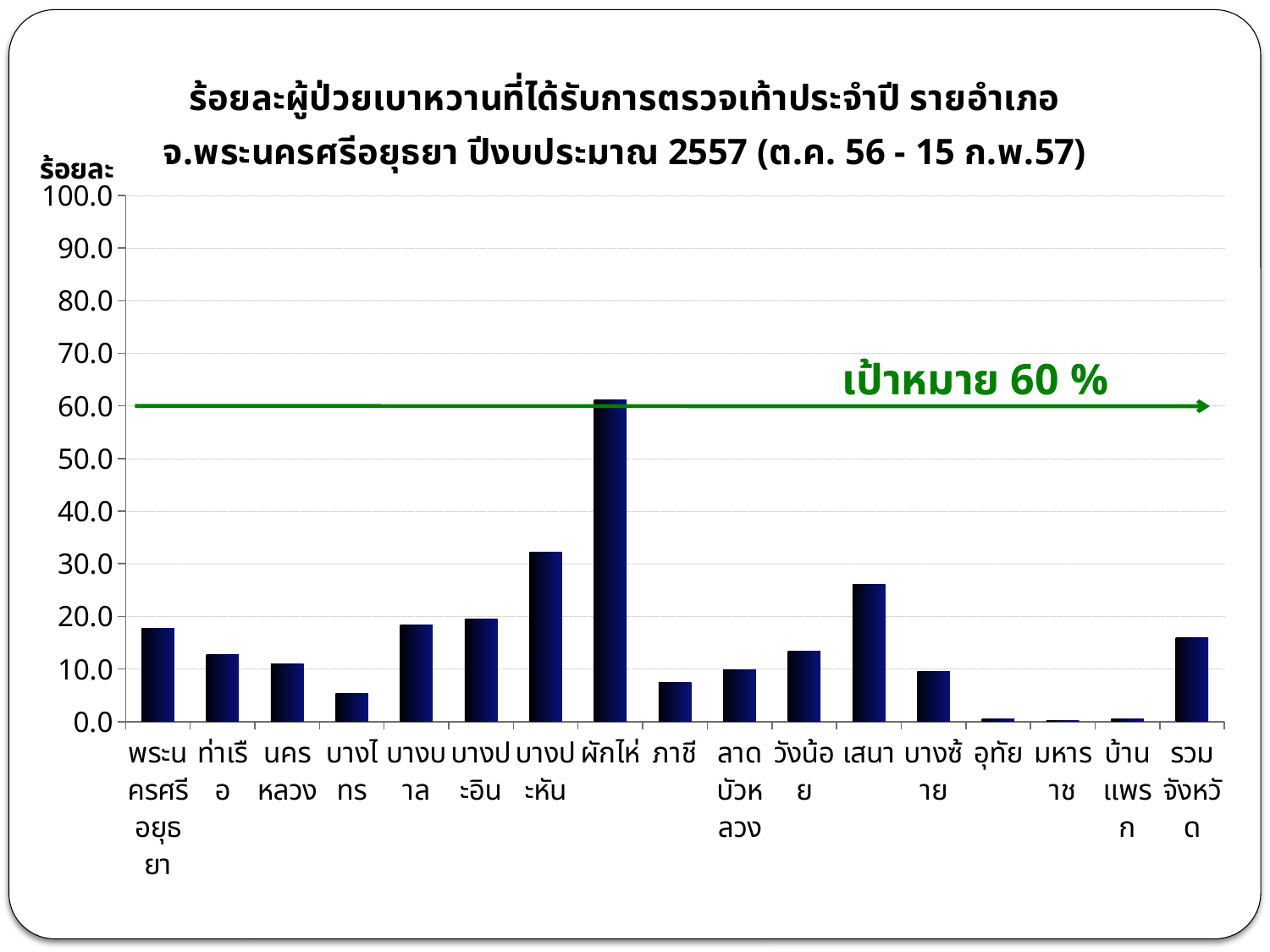
What target percentage is marked by the green line on the chart? 60 % Which category has the highest bar in the chart? ผักไห่ What kind of chart is shown on the slide? bar chart How many districts/categories are shown on the x axis of the chart? 17 Is the value for ผักไห่ greater or less than 50? greater Is the value for บางปะหัน greater or less than 20? greater Is the value for บางไทร greater or less than 10? less Which is larger, the value for เสนา or the value for ภาชี? เสนา Which is larger, the value for ผักไห่ or the value for บางปะหัน? ผักไห่ What is the label on the y axis of the chart? ร้อยละ